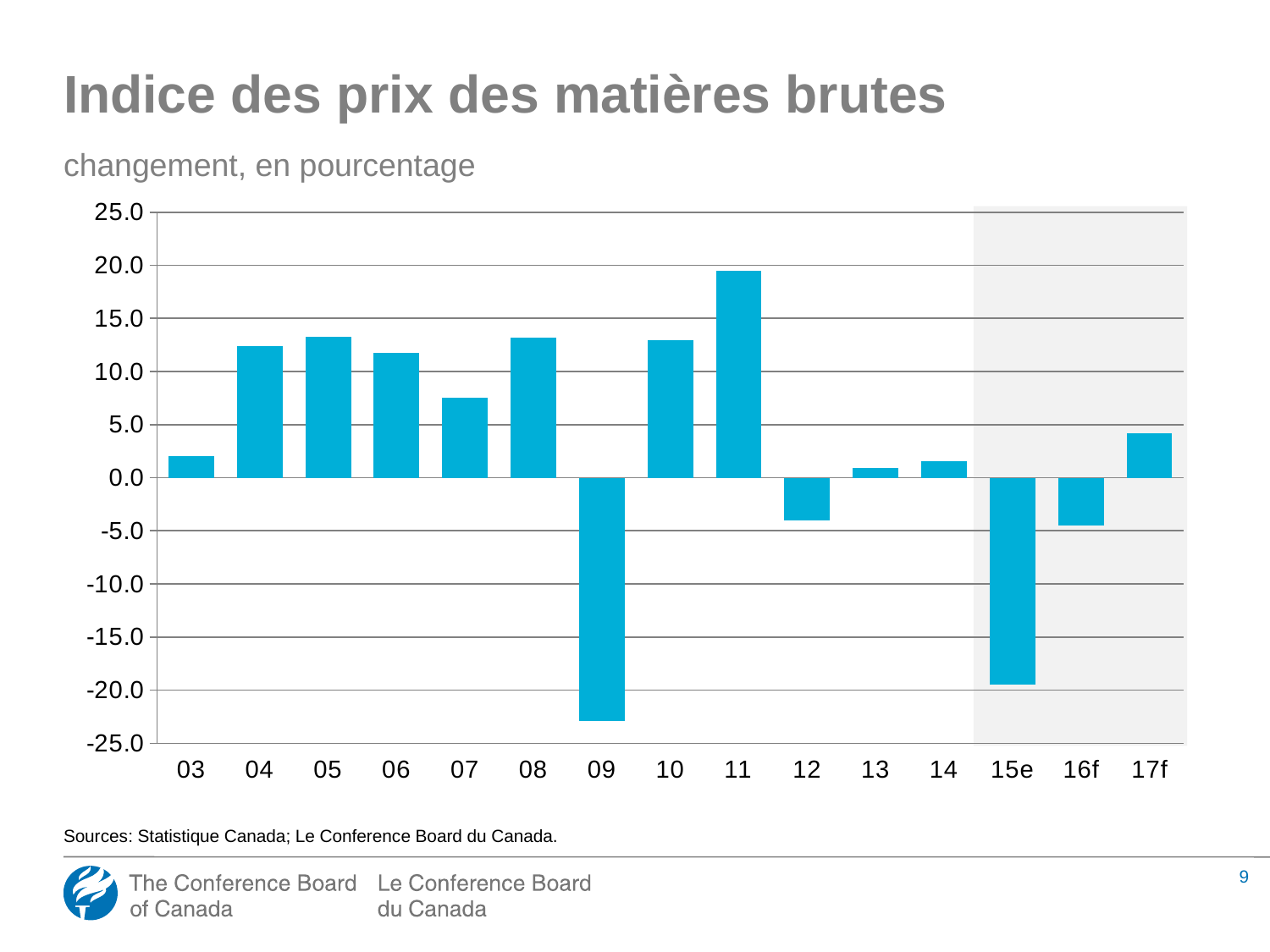
Which year has the highest value? 11 What is the title of the chart? Indice des prix des matières brutes Is the value for 17f greater or less than 5.0? less Do the values rise or fall from 12 to 14? rise Is the value for 11 greater or less than 15.0? greater How many years (categories) are plotted on the x axis? 15 Which is larger, the value for 11 or the value for 07? 11 Is the value for 09 greater or less than -20.0? less Which year has the lowest value? 09 What kind of chart is shown on the slide? bar chart